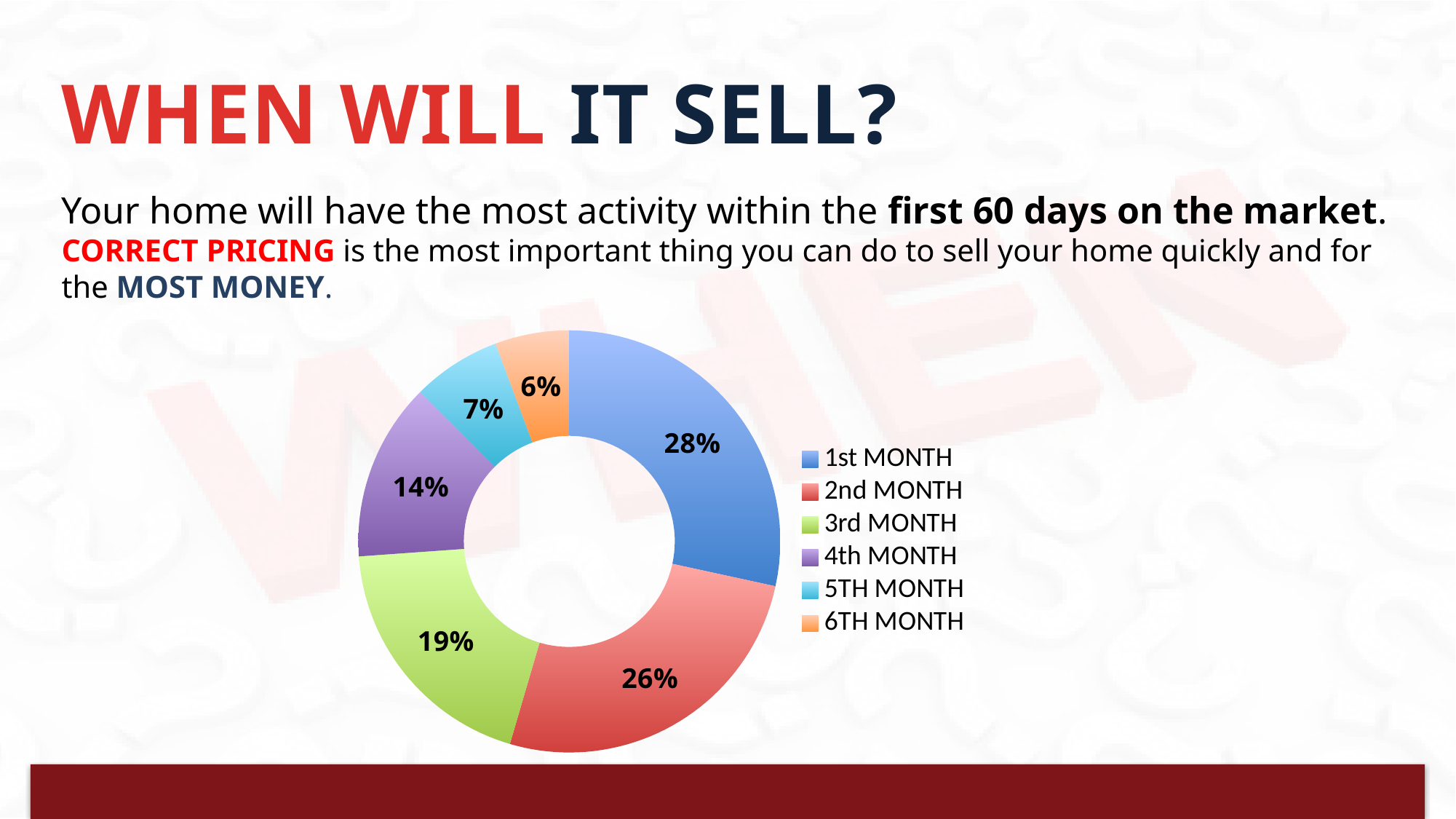
What colour is the slice for 6TH MONTH? Orange What is the difference in percentage points between 2nd MONTH and 4th MONTH? 12 What percentage is shown for 3rd MONTH? 19% What kind of chart is shown on the slide? Doughnut chart What is the combined share of 1st MONTH and 2nd MONTH? 54% Which month has the largest share of the chart? 1st MONTH What percentage is shown for 5TH MONTH? 7% Which is larger, the share for 3rd MONTH or the share for 4th MONTH? 3rd MONTH Which legend entry is listed last? 6TH MONTH What percentage is shown for 1st MONTH? 28% How many categories does the chart show? 6 Which month has the smallest share of the chart? 6TH MONTH